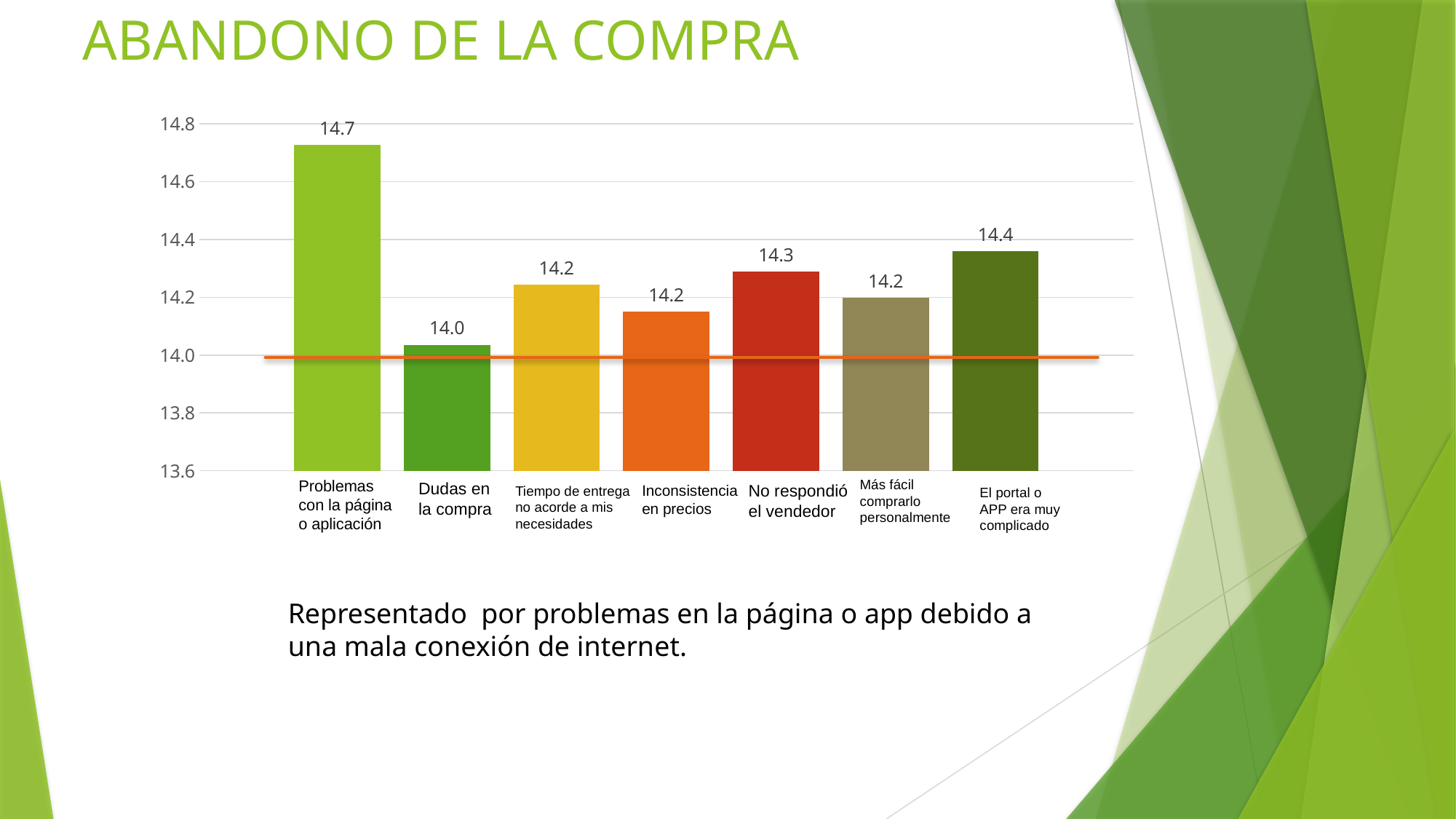
What is the value for "Problemas con la página o aplicación"? 14.7 How many categories are shown in the chart? 7 What is the difference between the values for "Problemas con la página o aplicación" and "Dudas en la compra"? 0.7 What is the title of the slide containing the chart? ABANDONO DE LA COMPRA Which category has the highest value? Problemas con la página o aplicación Which is larger, the value for "El portal o APP era muy complicado" or the value for "No respondió el vendedor"? El portal o APP era muy complicado What is the value for "El portal o APP era muy complicado"? 14.4 Is the value for "Inconsistencia en precios" greater or less than 14.0? greater What is the value for "Dudas en la compra"? 14.0 What is the value for "No respondió el vendedor"? 14.3 What kind of chart is shown on the slide? Bar chart Which category has the lowest value? Dudas en la compra